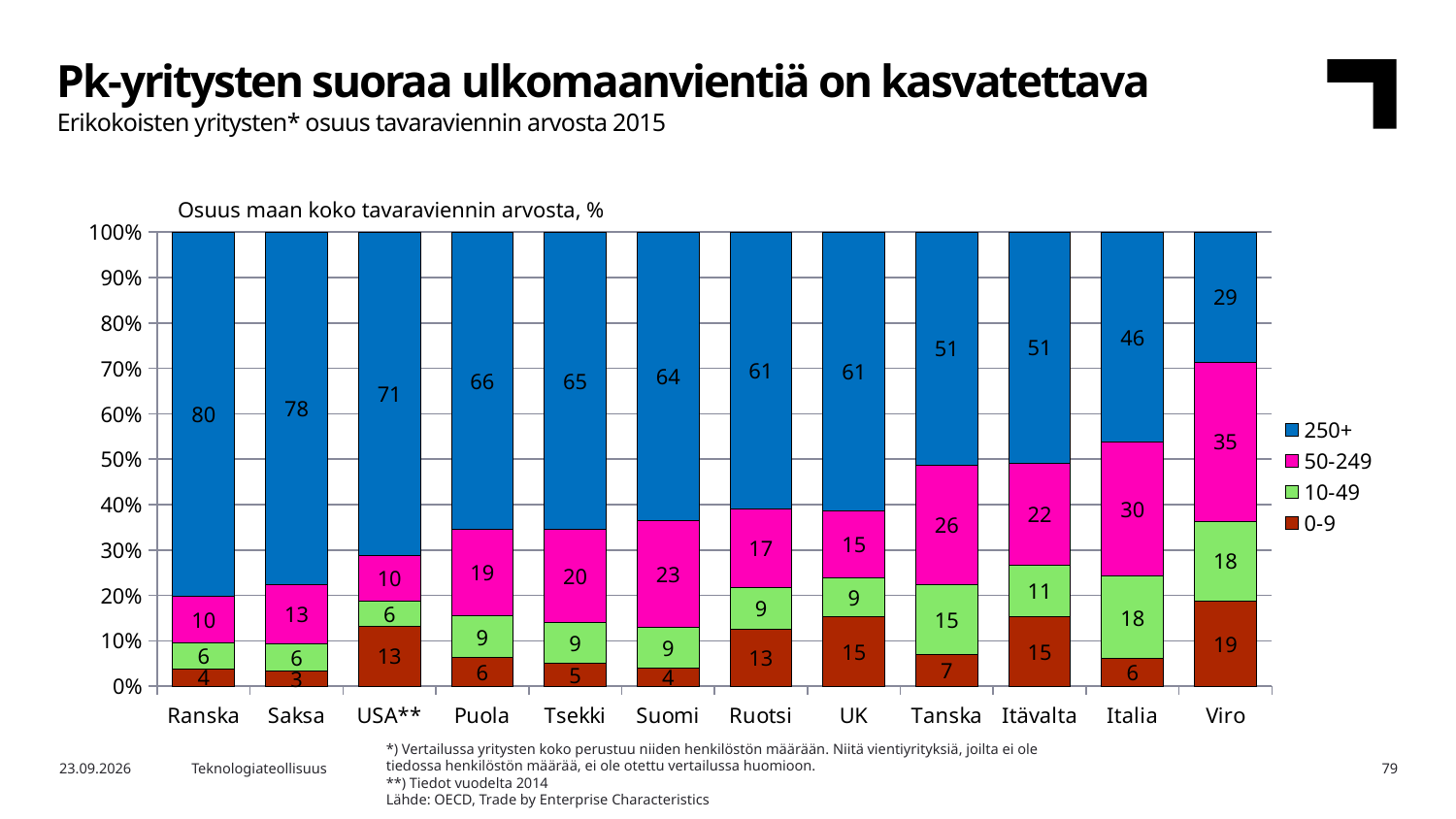
What is the difference between the 250+ values for Saksa and Viro? 49 What kind of chart is shown on the slide? Stacked bar chart What is the value of the 250+ series for Ranska? 80 Which is larger: the 0-9 value for Ruotsi or the 0-9 value for Tanska? Ruotsi How many series does the legend list? 4 What is the value of the 0-9 series for USA**? 13 Which country has the highest value for the 250+ series? Ranska Which country has the lowest value for the 250+ series? Viro What is the value of the 10-49 series for Italia? 18 How many countries are shown on the x axis? 12 Which country has the highest value for the 50-249 series? Viro What is the value of the 50-249 series for Suomi? 23